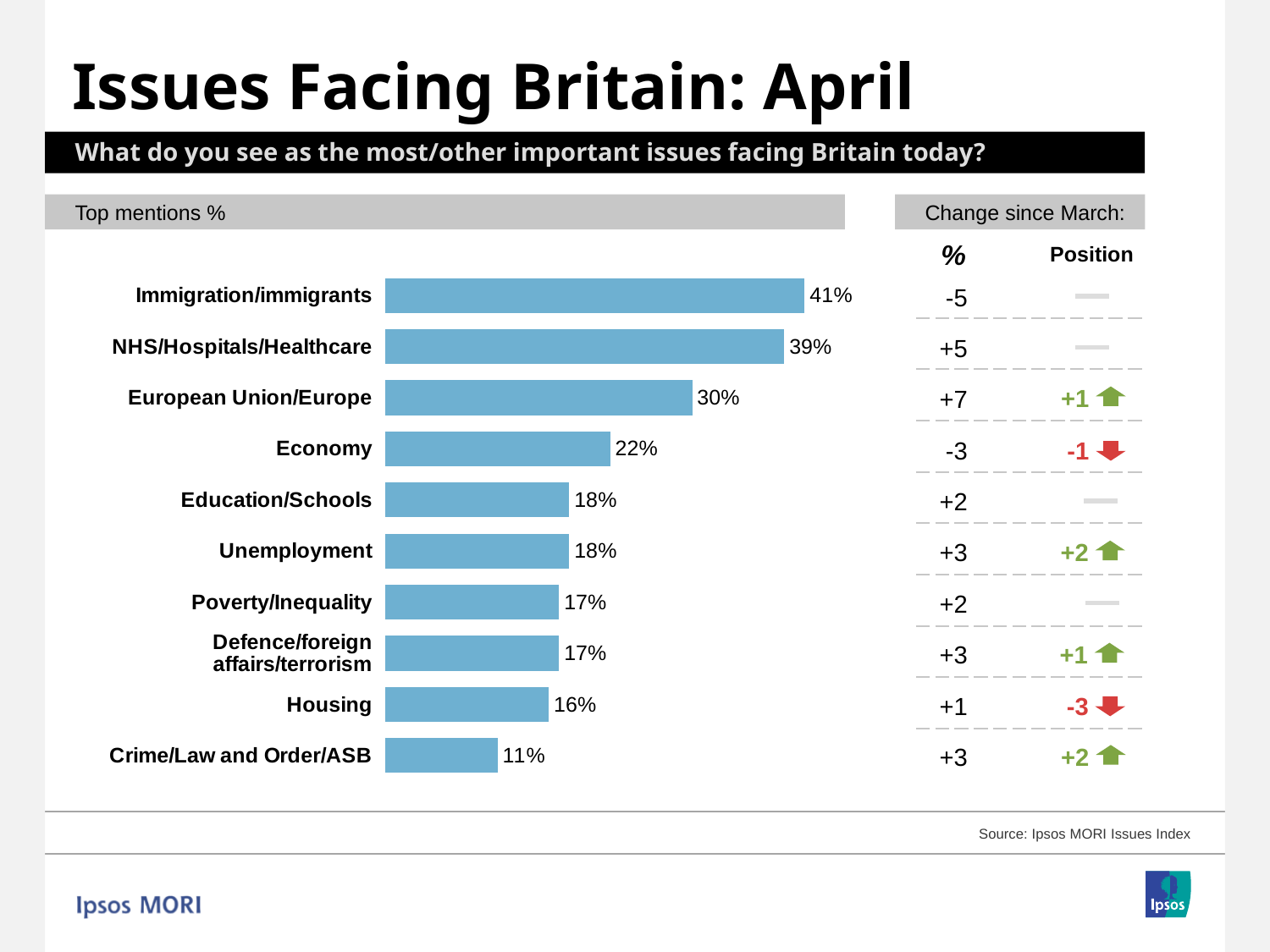
What is the value shown for European Union/Europe? 30% Which issue has the lowest percentage of mentions? Crime/Law and Order/ASB What is the difference in percentage points between Immigration/immigrants and NHS/Hospitals/Healthcare? 2 What type of chart is used to show the top mentions? Bar chart What is the change since March in percentage points for European Union/Europe? +7 Which has a higher percentage of mentions, European Union/Europe or Economy? European Union/Europe What is the difference in percentage points between Economy and Crime/Law and Order/ASB? 11 How many issues are listed in the bar chart? 10 Which issue has the highest percentage of mentions? Immigration/immigrants What percentage of respondents mentioned Immigration/immigrants as an important issue? 41% What percentage is shown for Housing? 16% What is the change in position since March for Housing? -3